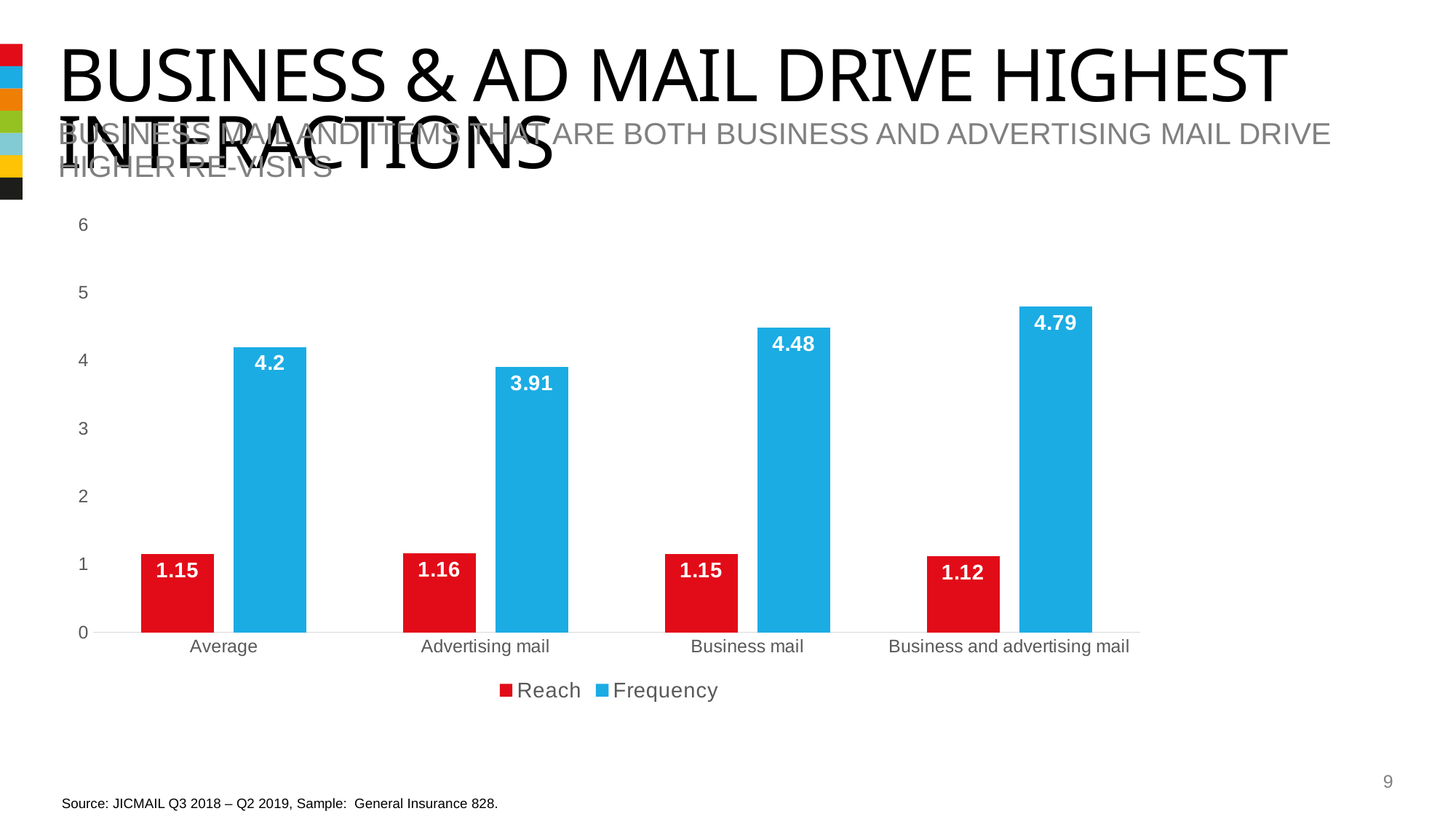
How many series does the legend list? 2 Which is larger, the Frequency value for Business mail or for Advertising mail? Business mail What is the Frequency value for Advertising mail? 3.91 How many categories are shown on the x axis? 4 Is the Frequency value for Business and advertising mail greater or less than 4? greater What is the difference between the Frequency values for Business and advertising mail and Average? 0.59 What is the Reach value for Business and advertising mail? 1.12 Which category has the lowest Frequency value? Advertising mail What is the Frequency value for Business mail? 4.48 What kind of chart is shown on the slide? Bar chart Which category has the highest Frequency value? Business and advertising mail Which colour represents the Reach series? Red